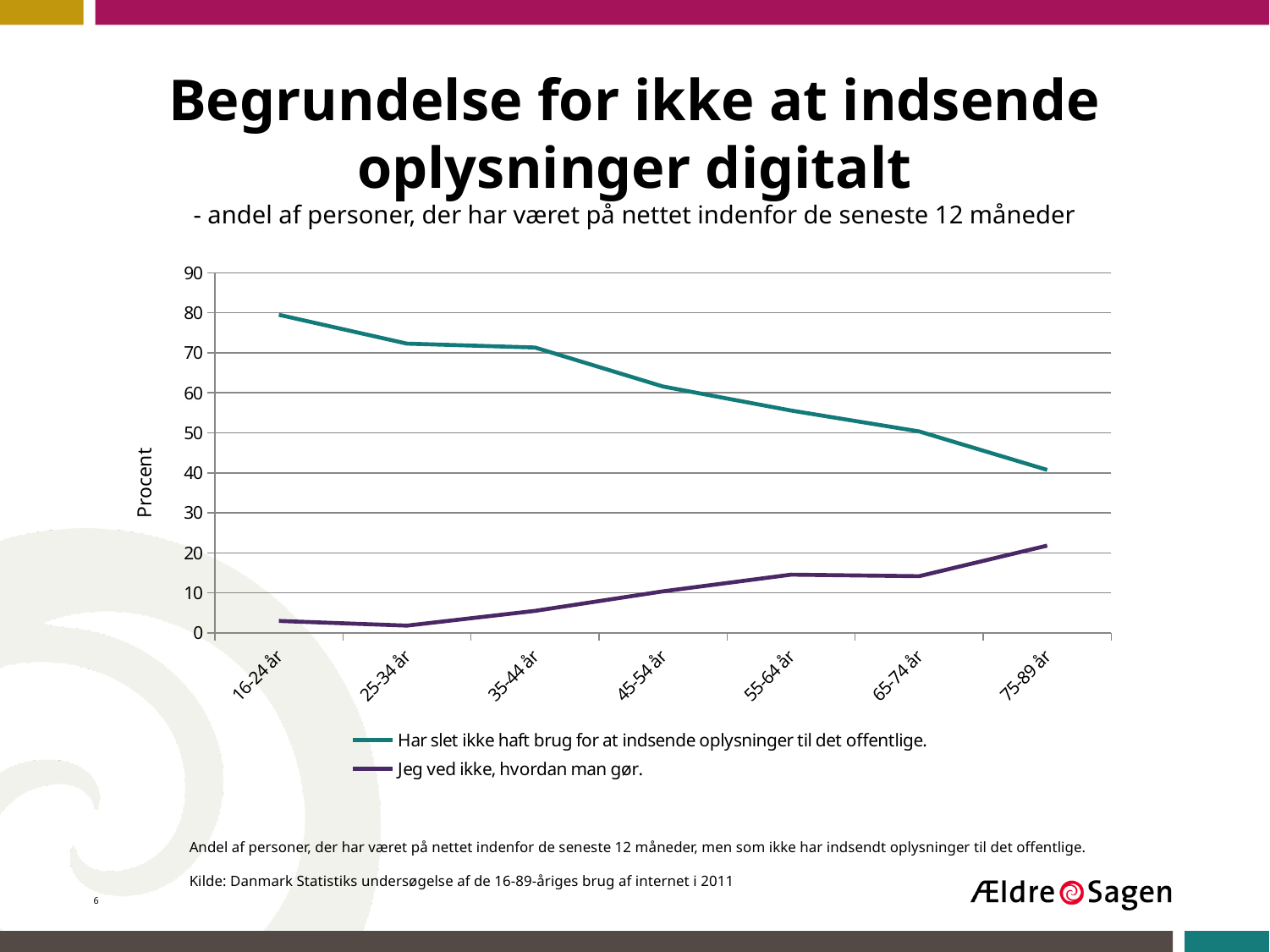
Does the series 'Jeg ved ikke, hvordan man gør.' generally rise or fall as age increases along the x axis? rise How many series does the legend list? 2 Which age group has the lowest value for 'Har slet ikke haft brug for at indsende oplysninger til det offentlige.'? 75-89 år For the age group 45-54 år, which series has the larger value: 'Har slet ikke haft brug for at indsende oplysninger til det offentlige.' or 'Jeg ved ikke, hvordan man gør.'? Har slet ikke haft brug for at indsende oplysninger til det offentlige. Is the value for 16-24 år in the series 'Har slet ikke haft brug for at indsende oplysninger til det offentlige.' greater or less than 70? greater What kind of chart is shown on the slide? line chart Which age group has the highest value for 'Har slet ikke haft brug for at indsende oplysninger til det offentlige.'? 16-24 år Which age group has the highest value for 'Jeg ved ikke, hvordan man gør.'? 75-89 år Is the value for 75-89 år in the series 'Jeg ved ikke, hvordan man gør.' greater or less than 30? less How many age groups are shown on the x axis? 7 What is the label on the vertical axis of the chart? Procent Does the series 'Har slet ikke haft brug for at indsende oplysninger til det offentlige.' rise or fall as age increases along the x axis? fall